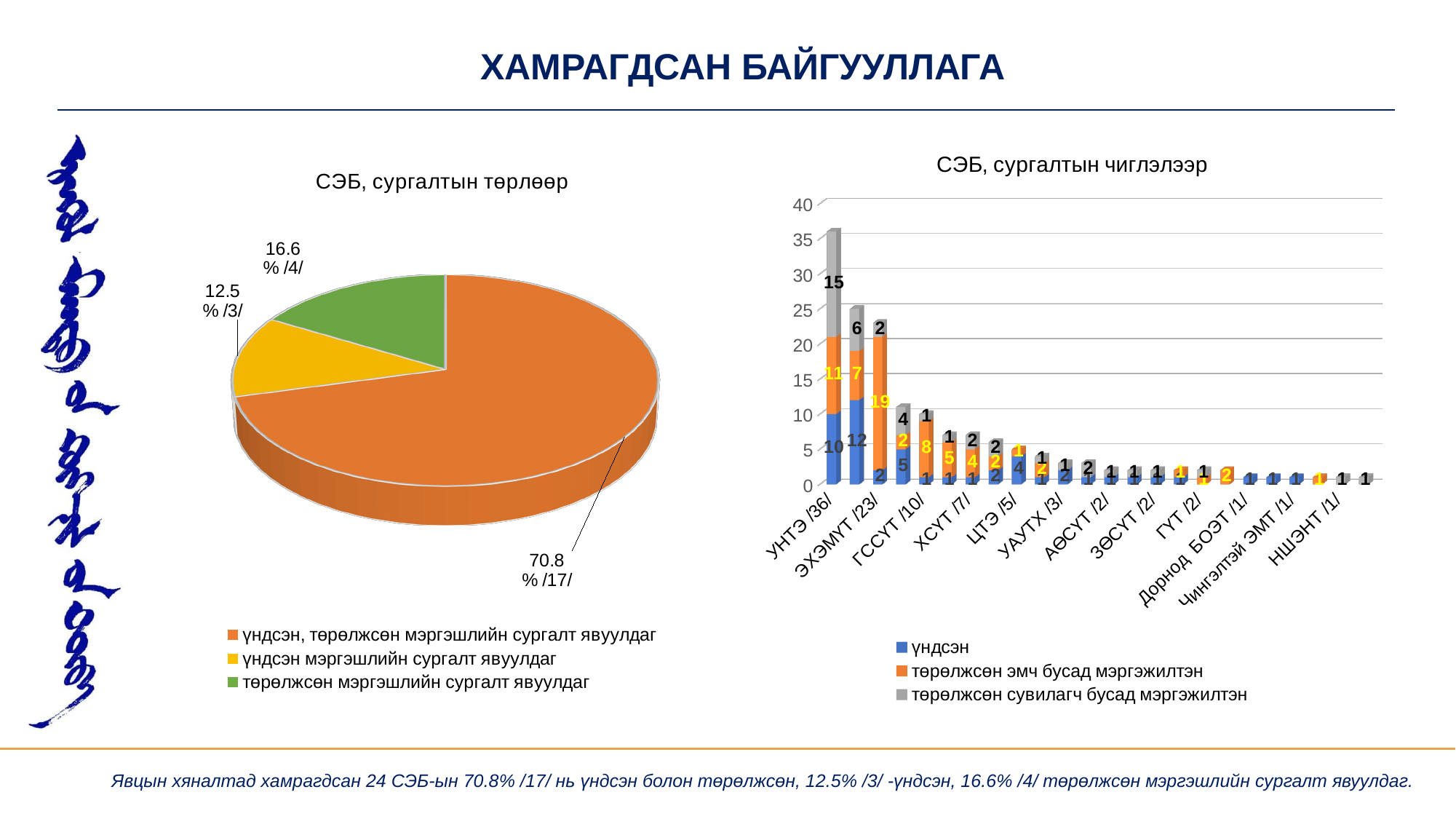
In the chart 'СЭБ, сургалтын чиглэлээр', what is the value of the 'үндсэн' series for ЭХЭМҮТ /23/? 2 What kind of chart is the chart titled 'СЭБ, сургалтын чиглэлээр'? stacked bar chart In the chart 'СЭБ, сургалтын чиглэлээр', what is the total of the stacked bar for УНТЭ /36/? 36 In the pie chart 'СЭБ, сургалтын төрлөөр', what share does the slice 'төрөлжсөн мэргэшлийн сургалт явуулдаг' have? 16.6% How many slices does the pie chart 'СЭБ, сургалтын төрлөөр' have? 3 What kind of chart is the chart titled 'СЭБ, сургалтын төрлөөр'? pie chart In the chart 'СЭБ, сургалтын чиглэлээр', what is the value of the 'төрөлжсөн сувилагч бусад мэргэжилтэн' series for УНТЭ /36/? 15 In the chart 'СЭБ, сургалтын чиглэлээр', which category has the tallest bar? УНТЭ /36/ How many series does the legend of the chart 'СЭБ, сургалтын чиглэлээр' list? 3 In the pie chart 'СЭБ, сургалтын төрлөөр', which category has the largest slice? үндсэн, төрөлжсөн мэргэшлийн сургалт явуулдаг In the pie chart 'СЭБ, сургалтын төрлөөр', what share does the slice 'үндсэн мэргэшлийн сургалт явуулдаг' have? 12.5%